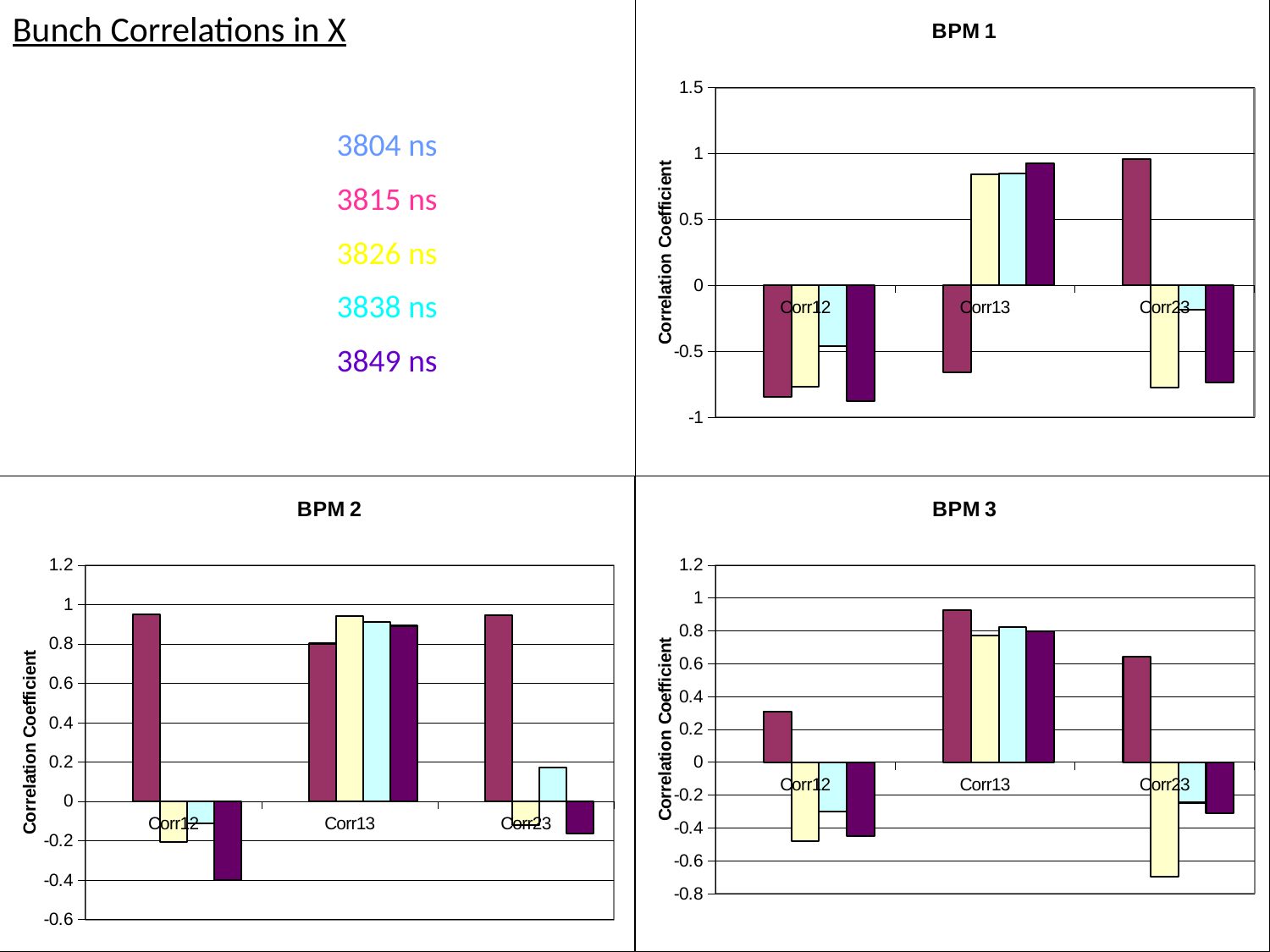
In the BPM 1 chart, is the highest value for Corr13 greater or less than 0.5? greater In the BPM 2 chart, which category has all of its bars above 0? Corr13 In the BPM 2 chart, is the lowest value for Corr12 greater or less than -0.2? less In the BPM 3 chart, is the lowest value for Corr13 greater or less than 0.6? greater What is the label on the y axis of the BPM 3 chart? Correlation Coefficient What kind of chart is the BPM 1 chart? bar chart How many bars are plotted for each category in the BPM 3 chart? 4 How many categories are shown on the x axis of the BPM 2 chart? 3 How many bar charts are shown on the slide? 3